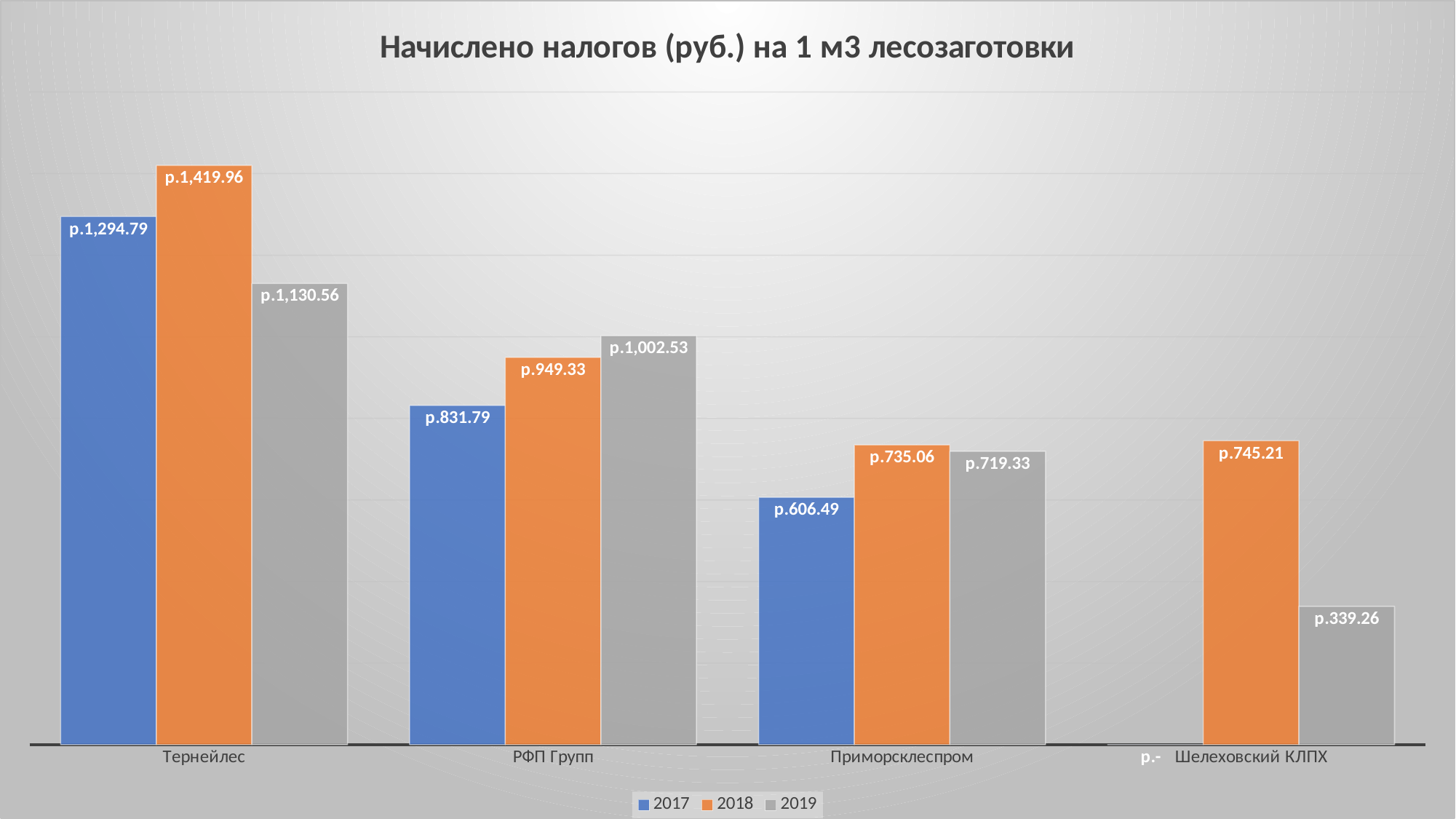
Which category has the highest 2018 value? Тернейлес What is the 2018 value for Тернейлес? р.1,419.96 Which category has the lowest 2019 value? Шелеховский КЛПХ For Приморсклеспром, which is larger: the 2018 value or the 2019 value? 2018 What is the difference between the 2018 and 2019 values for Шелеховский КЛПХ? р.405.95 What is the 2019 value for РФП Групп? р.1,002.53 What kind of chart is this? Bar chart How many series does the legend list? 3 How many categories are shown on the x axis? 4 What is the difference between the 2018 and 2017 values for Тернейлес? р.125.17 What is the 2017 value for Приморсклеспром? р.606.49 What is the 2019 value for Шелеховский КЛПХ? р.339.26